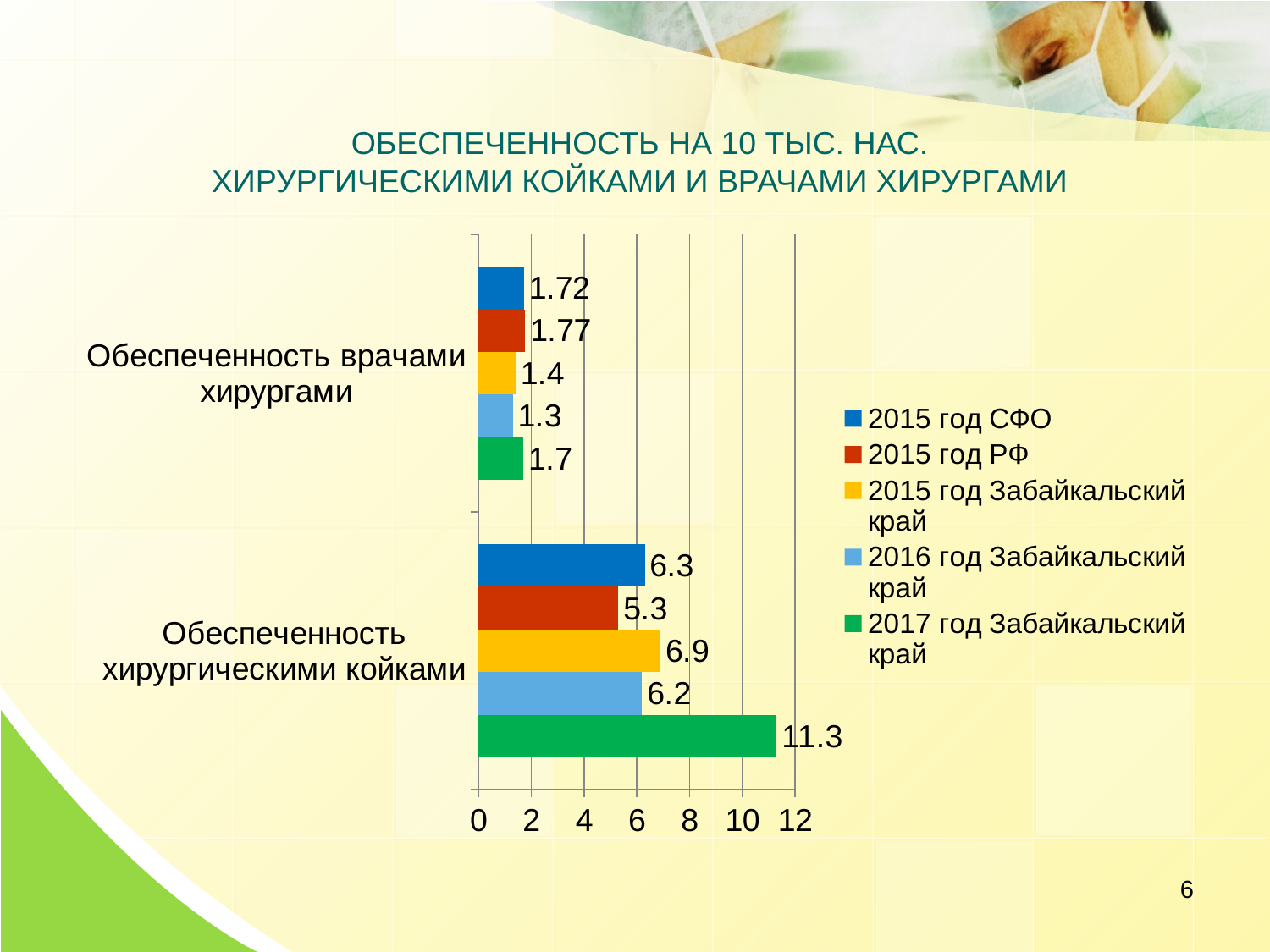
What is the value for 2015 год РФ in the Обеспеченность врачами хирургами category? 1.77 What is the value for 2017 год Забайкальский край in the Обеспеченность хирургическими койками category? 11.3 What kind of chart is shown on the slide? bar chart What colour represents 2015 год Забайкальский край in the chart? yellow What is the difference between the 2017 год Забайкальский край and 2016 год Забайкальский край values for Обеспеченность хирургическими койками? 5.1 Which is larger for Обеспеченность хирургическими койками: 2015 год СФО or 2015 год РФ? 2015 год СФО Which series has the lowest value in the Обеспеченность врачами хирургами category? 2016 год Забайкальский край Which series has the highest value in the Обеспеченность хирургическими койками category? 2017 год Забайкальский край Is the value for 2015 год Забайкальский край in Обеспеченность хирургическими койками greater or less than 8? less How many series does the legend list? 5 How many categories are shown on the chart? 2 What is the value for 2016 год Забайкальский край in the Обеспеченность хирургическими койками category? 6.2